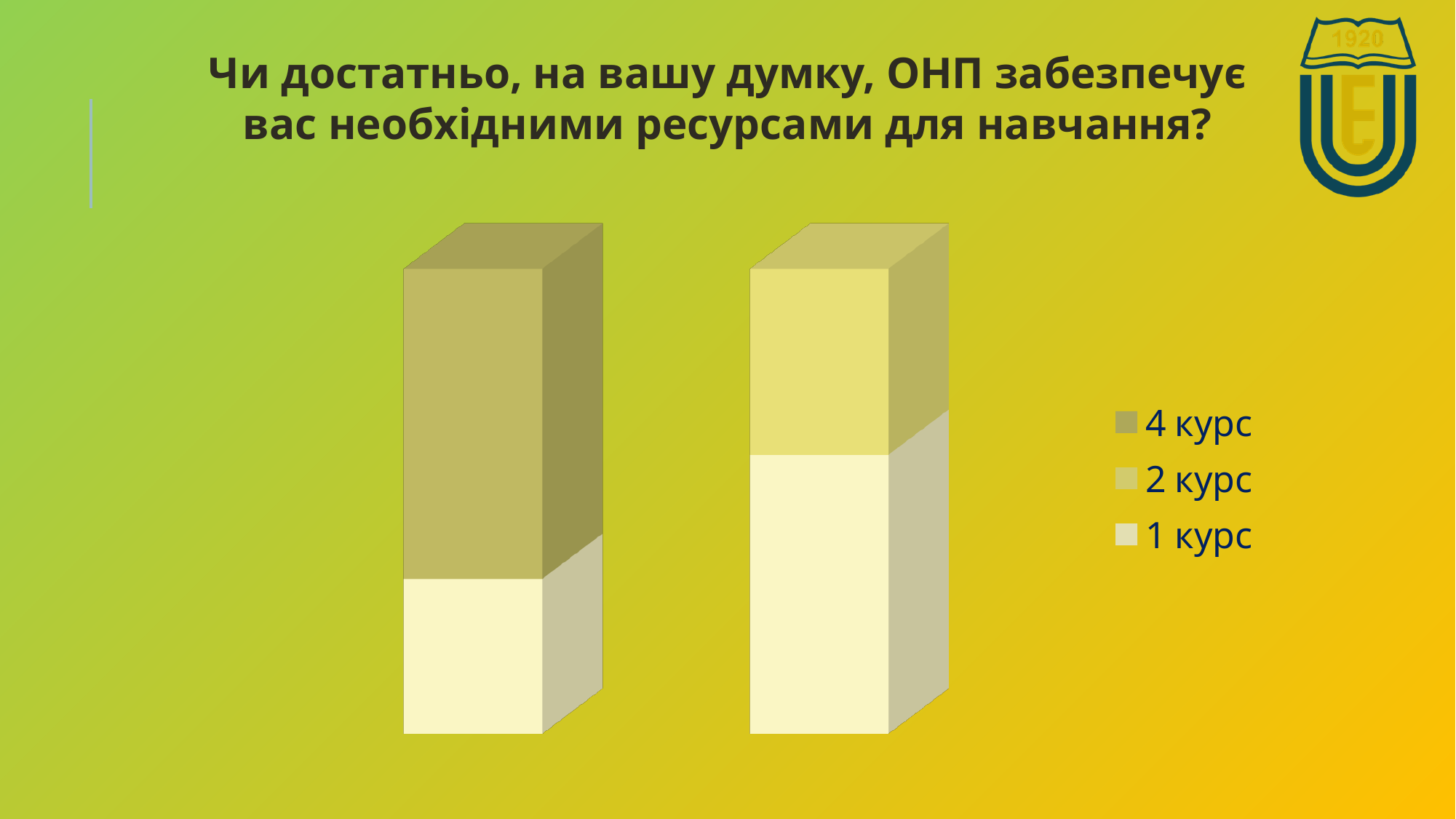
How many series does the chart legend list? 3 In the right bar, which segment is larger: 2 курс or 1 курс? 1 курс What is the title of the chart on the slide? Чи достатньо, на вашу думку, ОНП забезпечує вас необхідними ресурсами для навчання? What kind of chart is shown on the slide? Stacked bar chart In the left bar, which segment is larger: 4 курс or 1 курс? 4 курс Which series appears in both bars of the chart? 1 курс Which series are listed in the chart legend? 4 курс, 2 курс, 1 курс How many bars are plotted in the chart? 2